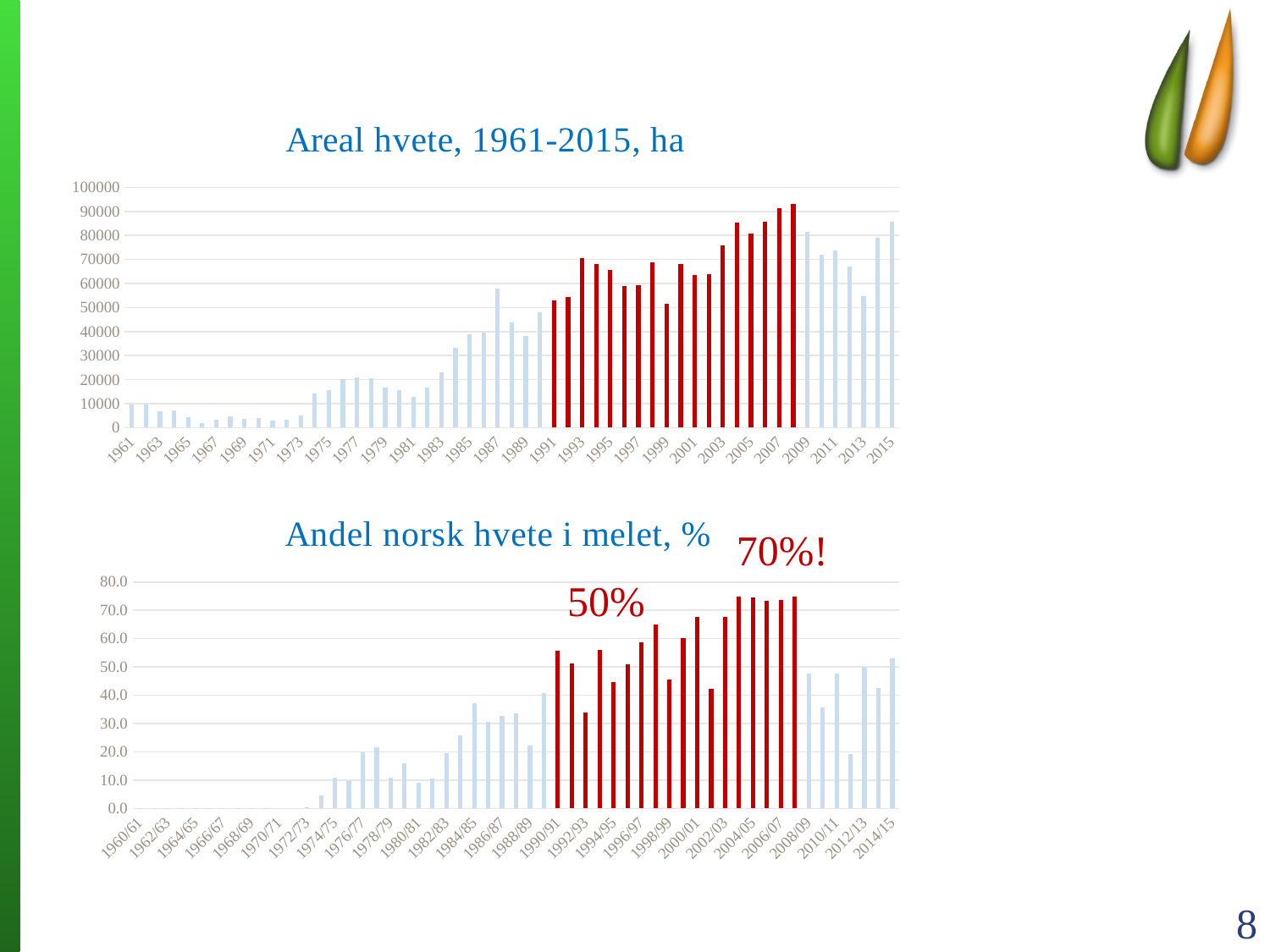
What is the title of the bottom chart? Andel norsk hvete i melet, % In the bottom chart "Andel norsk hvete i melet, %", is the value for 1992/93 greater or less than 40.0? less What kind of chart is the top chart titled "Areal hvete, 1961-2015, ha"? bar chart In the top chart "Areal hvete, 1961-2015, ha", which is larger, the value for 2015 or the value for 2013? 2015 In the top chart "Areal hvete, 1961-2015, ha", is the value for 1987 greater or less than 50000? greater In the top chart "Areal hvete, 1961-2015, ha", do the values generally rise or fall from 1961 to 2008? rise In the bottom chart "Andel norsk hvete i melet, %", is the value for 2000/01 greater or less than 60.0? greater What annotation text is written in red above the highest bars of the bottom chart? 70%! In the bottom chart "Andel norsk hvete i melet, %", which is larger, the value for 2004/05 or the value for 2009/10? 2004/05